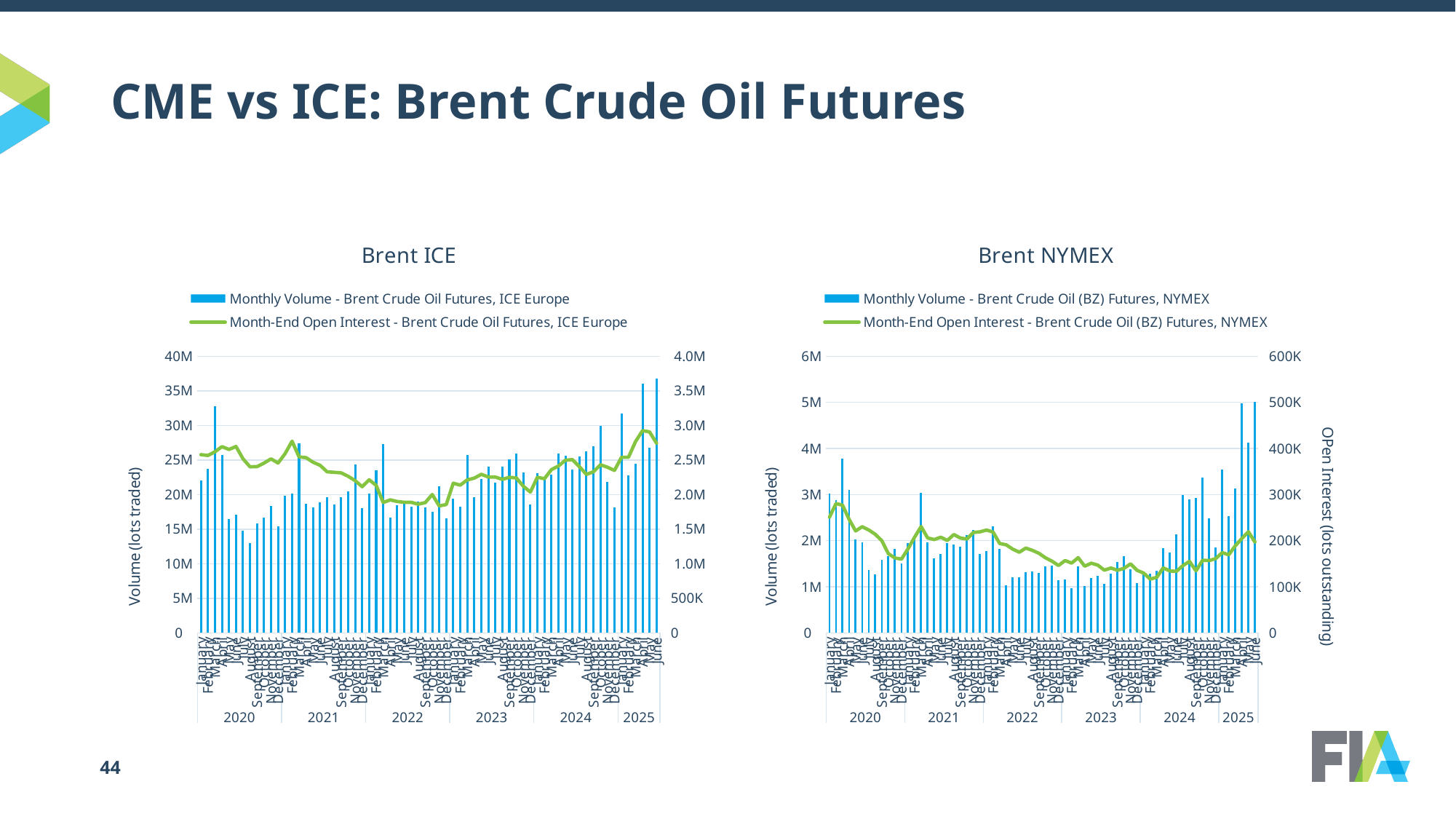
In the Brent NYMEX chart, is the tallest monthly volume bar greater or less than 4M? greater In the Brent ICE chart, is the tallest monthly volume bar greater or less than 35M? greater In the Brent ICE chart, is the open interest at the end of the series (June 2025) greater or less than 2.5M? greater How many years are labelled along the x axis of the Brent NYMEX chart? 6 Which chart has the higher peak monthly volume, Brent ICE or Brent NYMEX? Brent ICE How many charts are shown on the slide? 2 What kind of chart is the Brent ICE chart? Combined bar and line chart How many series does the legend of the Brent NYMEX chart list? 2 In the Brent NYMEX chart, what colour are the Monthly Volume bars? Blue In the Brent ICE chart, which series is drawn as a line? Month-End Open Interest - Brent Crude Oil Futures, ICE Europe